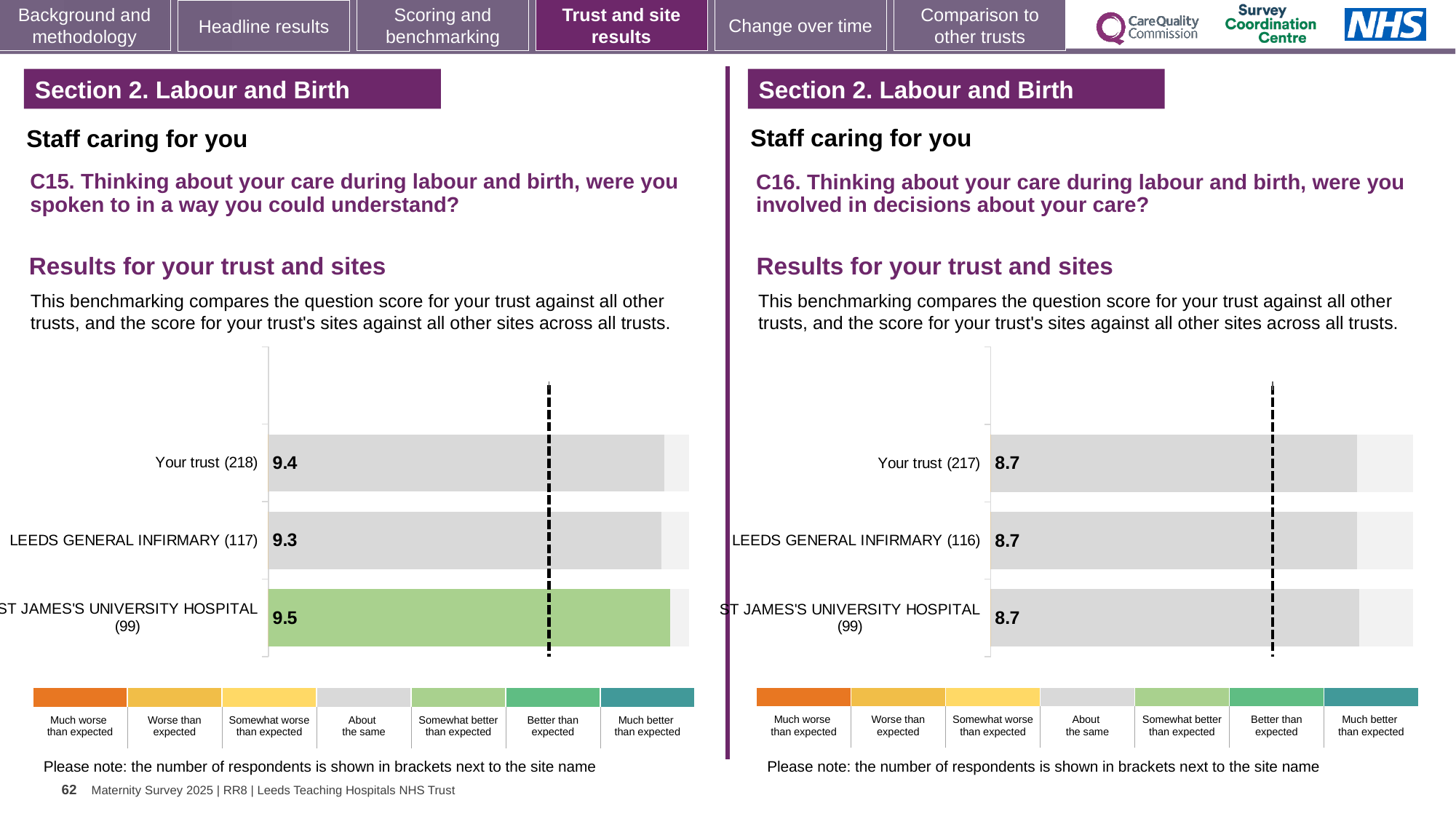
On the C16 chart (right), how many respondents are shown in brackets for LEEDS GENERAL INFIRMARY? 116 On the C15 chart (left), what is the score for LEEDS GENERAL INFIRMARY? 9.3 On the C16 chart (right), what is the score for Your trust? 8.7 On the C15 chart (left), which bar is coloured green rather than grey? ST JAMES'S UNIVERSITY HOSPITAL What type of chart is used on the C16 chart (right)? Bar chart On the C15 chart (left), what is the difference between the scores for ST JAMES'S UNIVERSITY HOSPITAL and LEEDS GENERAL INFIRMARY? 0.2 On the C15 chart (left), what is the score for ST JAMES'S UNIVERSITY HOSPITAL? 9.5 On the C15 chart (left), how many bars are plotted? 3 On the C16 chart (right), what is the score for ST JAMES'S UNIVERSITY HOSPITAL? 8.7 On the C15 chart (left), which site or trust has the lowest score? LEEDS GENERAL INFIRMARY On the C15 chart (left), what is the score for Your trust? 9.4 On the C15 chart (left), which site or trust has the highest score? ST JAMES'S UNIVERSITY HOSPITAL